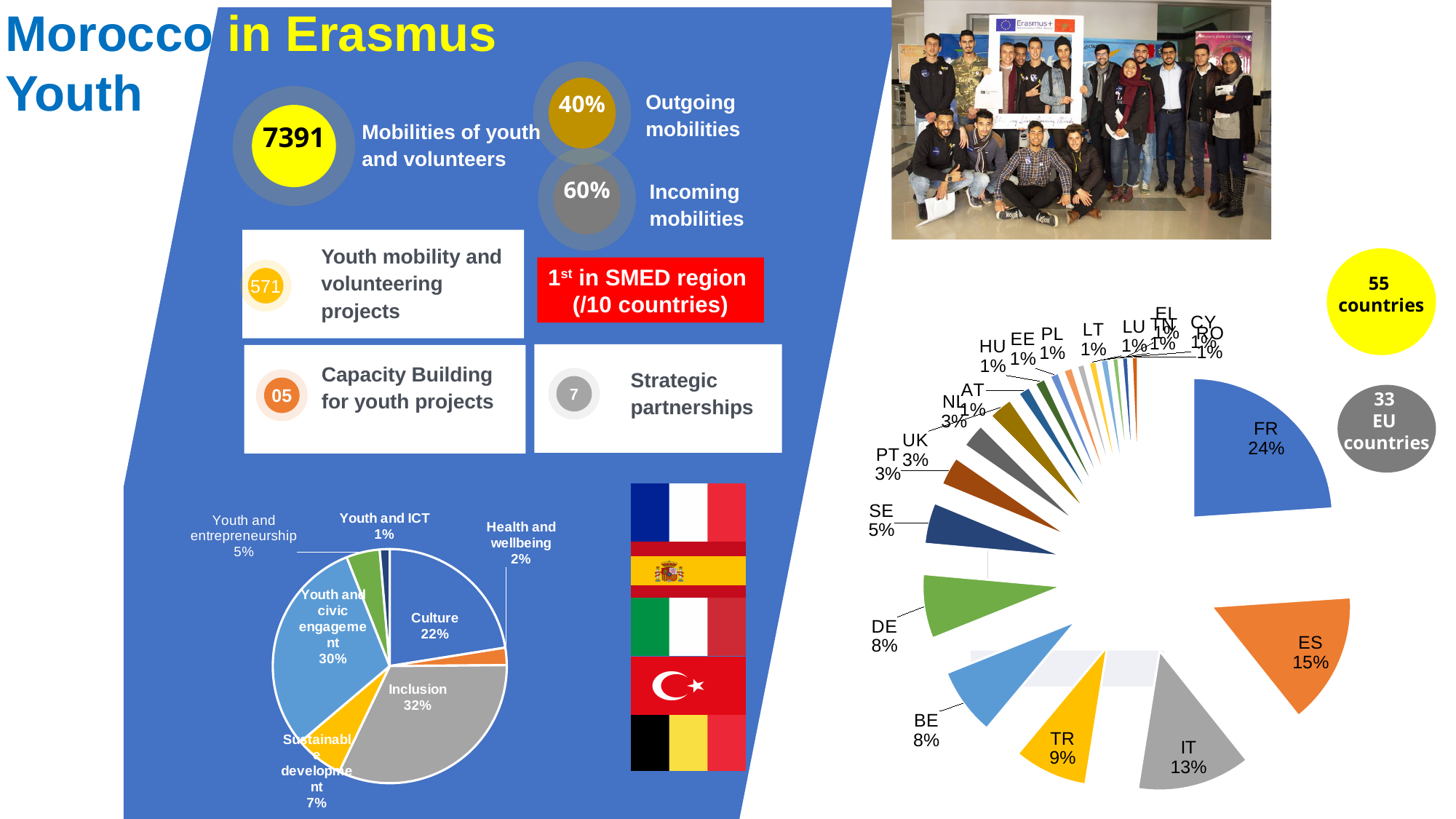
On the right pie chart, what is the difference between the shares of ES and IT? 2% On the right pie chart, what share does DE have? 8% On the left pie chart, which category has the largest share? Inclusion On the right pie chart, which is larger: TR or SE? TR What type of chart is the chart on the right side of the slide showing countries? Pie chart On the right pie chart, what share does FR have? 24% On the right pie chart, which country has the largest share? FR How many categories does the left pie chart show? 7 On the left pie chart, which category has the smallest share? Youth and ICT On the left pie chart, what is the difference between the shares of Inclusion and Culture? 10% On the left pie chart, which is larger: Youth and civic engagement or Culture? Youth and civic engagement On the left pie chart, what share does Inclusion have? 32%